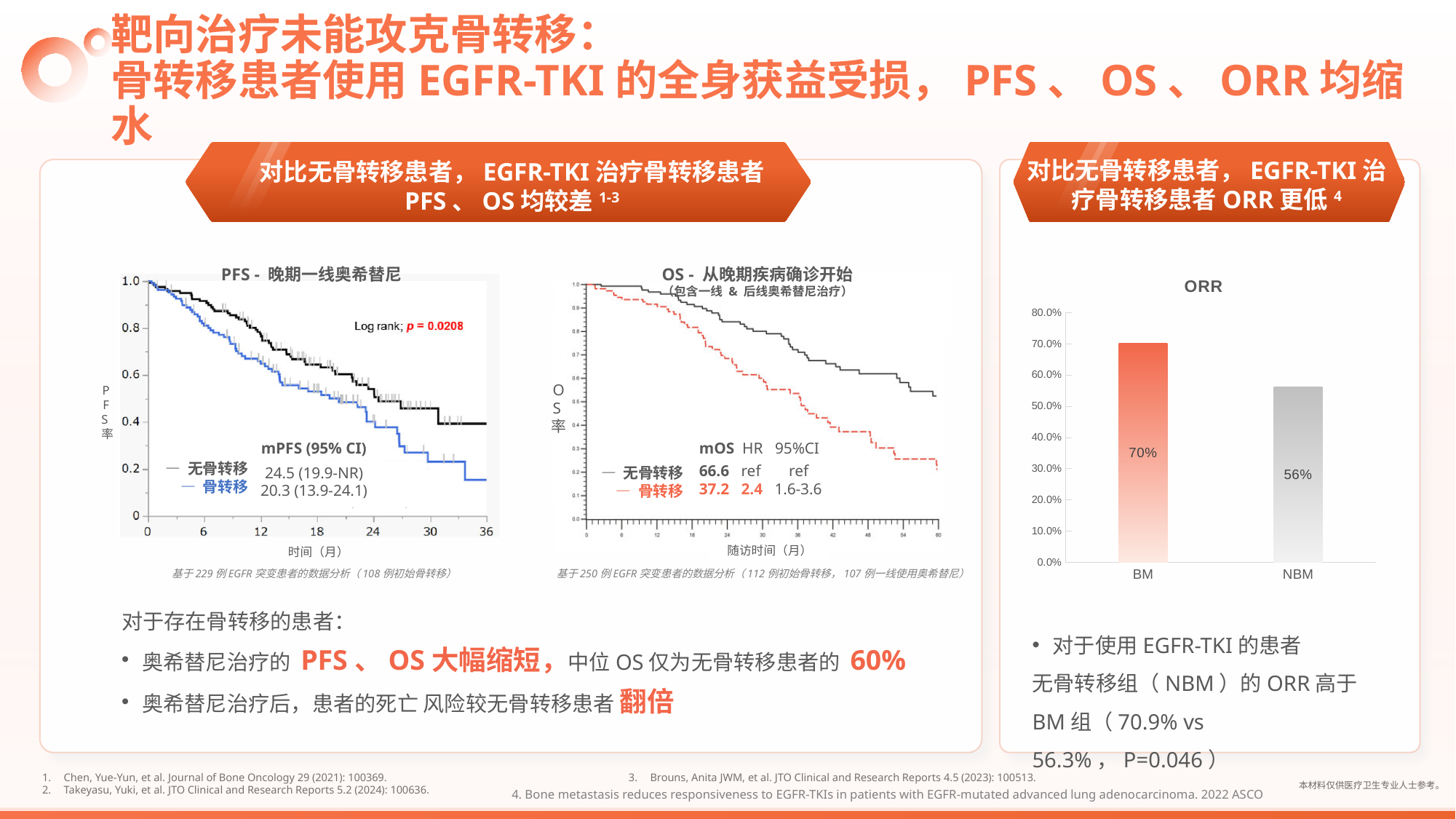
In the ORR chart, what is the ORR value for NBM? 56% In the OS chart (OS - 从晚期疾病确诊开始), what is the mOS for the 无骨转移 group? 66.6 In the OS chart (OS - 从晚期疾病确诊开始), how many groups does the legend list? 2 In the OS chart (OS - 从晚期疾病确诊开始), what is the HR for the 骨转移 group? 2.4 In the ORR chart, is the value for NBM greater or less than 60.0%? less In the PFS chart (PFS - 晚期一线奥希替尼), what is the mPFS for the 骨转移 group? 20.3 (13.9-24.1) In the ORR chart, how many categories are shown on the x axis? 2 What kind of chart is the ORR chart? Bar chart In the ORR chart, which group has the higher ORR, BM or NBM? BM In the ORR chart, what is the difference between the BM and NBM values? 14% In the ORR chart, what is the ORR value for BM? 70% In the PFS chart (PFS - 晚期一线奥希替尼), what is the log rank p value shown? p = 0.0208